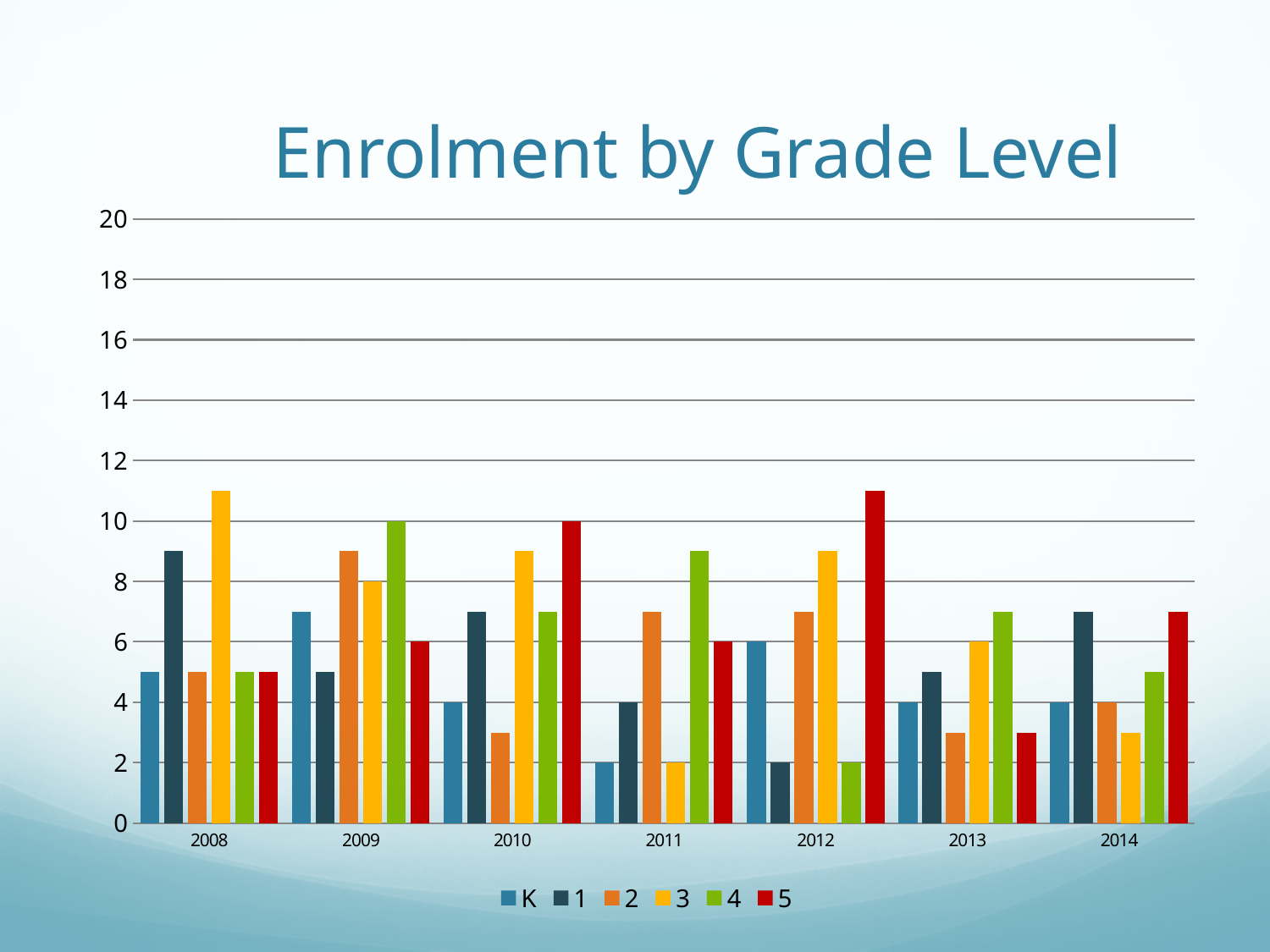
Which grade has the highest enrolment in 2012? 5 How many series does the legend list? 6 What is the enrolment for K in 2012? 6 How many years are shown on the x axis? 7 What is the enrolment for grade 4 in 2009? 10 What is the difference between the grade 5 and K enrolment in 2010? 6 What is the title of the chart? Enrolment by Grade Level What is the enrolment for grade 5 in 2010? 10 What type of chart is shown on the slide? bar chart In 2012, which is larger, the enrolment for K or for grade 1? K Is the value for grade 3 in 2008 greater or less than 10? greater What is the enrolment for grade 3 in 2013? 6